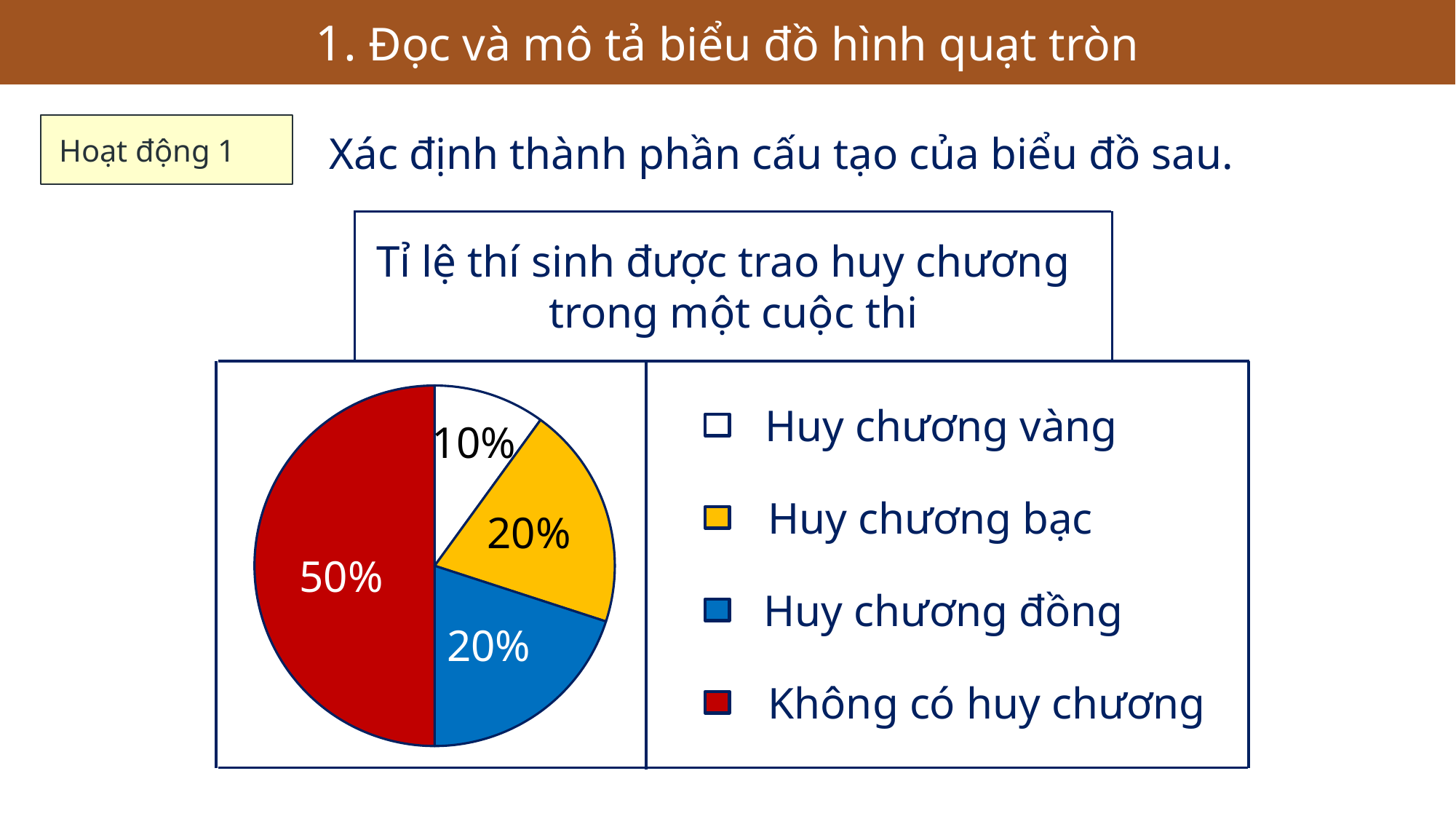
Which category has the largest slice of the pie? Không có huy chương How many entries does the legend list? 4 What percentage of the pie is labelled for Không có huy chương? 50% What is the title of the chart? Tỉ lệ thí sinh được trao huy chương trong một cuộc thi What percentage of the pie is labelled for Huy chương bạc? 20% What percentage of the pie is labelled for Huy chương vàng? 10% What kind of chart is shown on the slide? Pie chart What is the difference between the share for Không có huy chương and the share for Huy chương vàng? 40% Which is larger, the slice for Huy chương bạc or the slice for Huy chương vàng? Huy chương bạc What percentage of the pie is labelled for Huy chương đồng? 20% How many slices does the pie chart have? 4 Which category has the smallest slice of the pie? Huy chương vàng